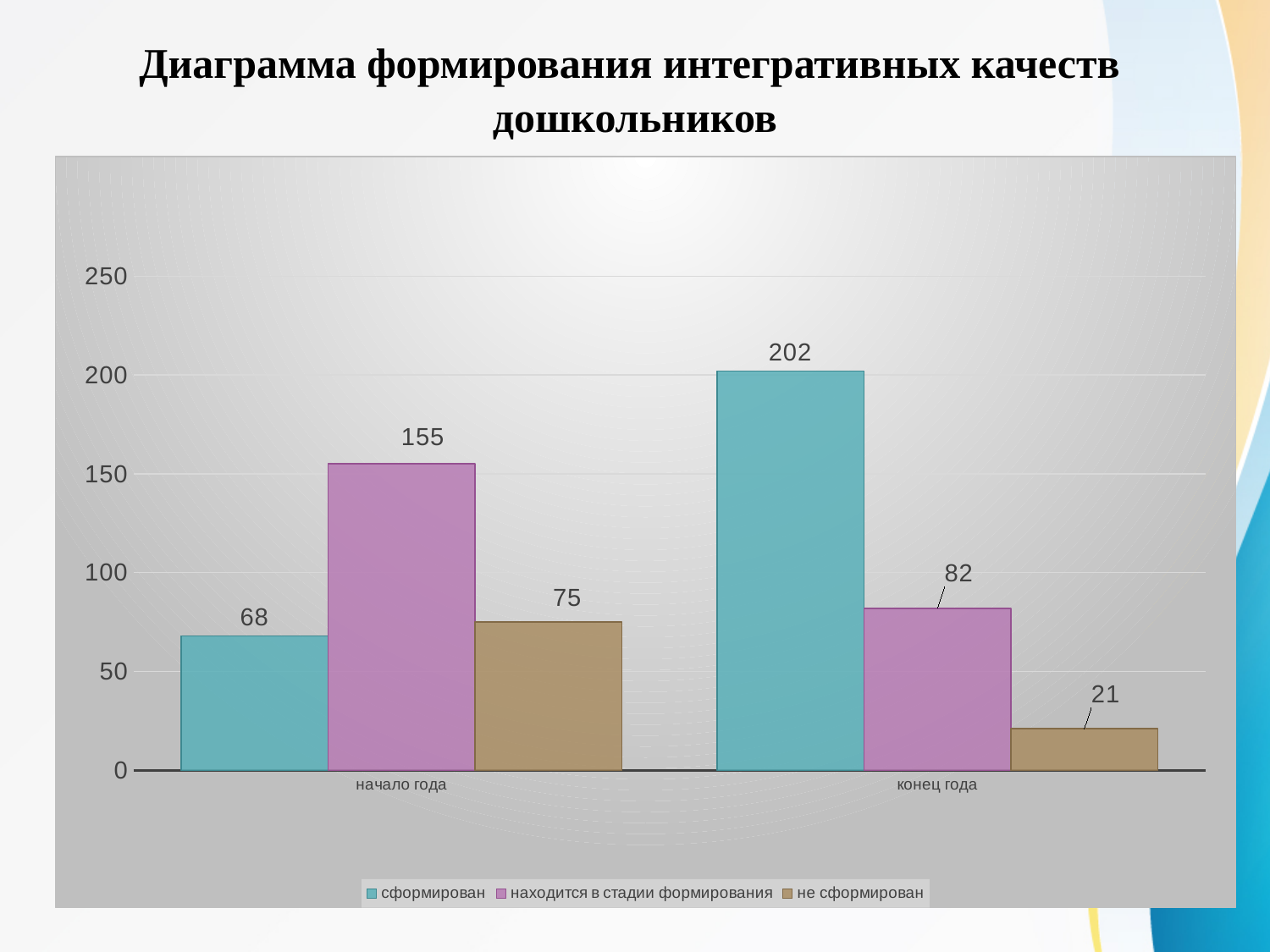
What is the value for "находится в стадии формирования" at "конец года"? 82 Is the value for "сформирован" at "конец года" greater or less than 150? greater What is the difference between the "сформирован" values at "конец года" and "начало года"? 134 What is the value for "сформирован" at "начало года"? 68 How many series does the legend list? 3 Which series has the highest value at "начало года"? находится в стадии формирования What is the title of the chart on the slide? Диаграмма формирования интегративных качеств дошкольников What kind of chart is shown on the slide? bar chart How many categories are shown on the x axis? 2 Which series has the lowest value at "конец года"? не сформирован What is the value for "не сформирован" at "конец года"? 21 Which is larger: "не сформирован" at "начало года" or "не сформирован" at "конец года"? начало года